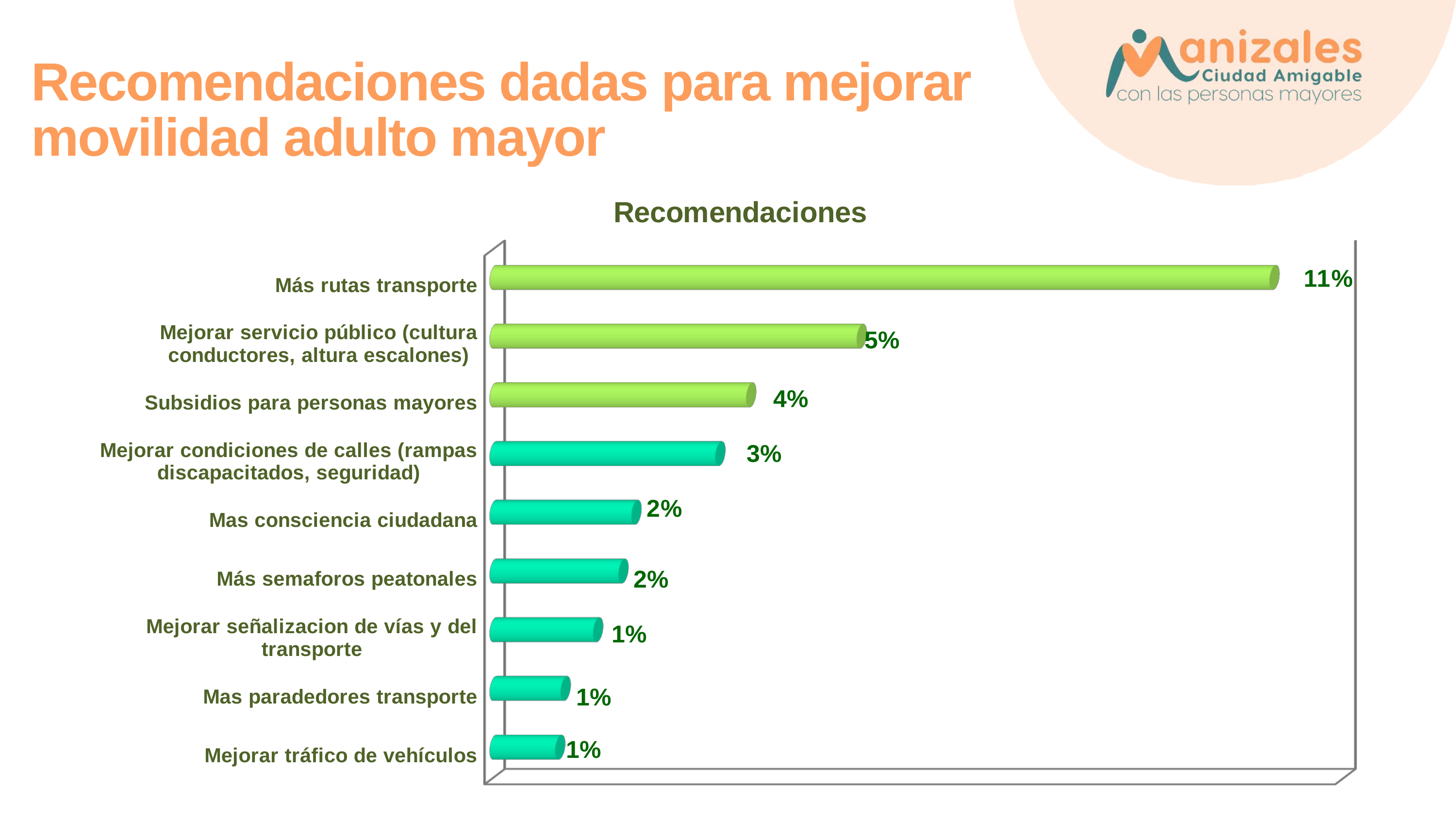
What is the difference between "Subsidios para personas mayores" and "Mas consciencia ciudadana"? 2% What is the value for "Subsidios para personas mayores"? 4% Which is larger, the value for "Subsidios para personas mayores" or the value for "Más semaforos peatonales"? Subsidios para personas mayores What is the value for "Mejorar condiciones de calles (rampas discapacitados, seguridad)"? 3% How many categories have a value of 1%? 3 What is the value for "Más rutas transporte"? 11% Which category has the highest value? Más rutas transporte How many categories are shown in the chart? 9 What is the title of the chart? Recomendaciones What kind of chart is shown on the slide? Bar chart What is the value for "Mejorar servicio público (cultura conductores, altura escalones)"? 5% What is the difference between "Más rutas transporte" and "Mejorar servicio público (cultura conductores, altura escalones)"? 6%